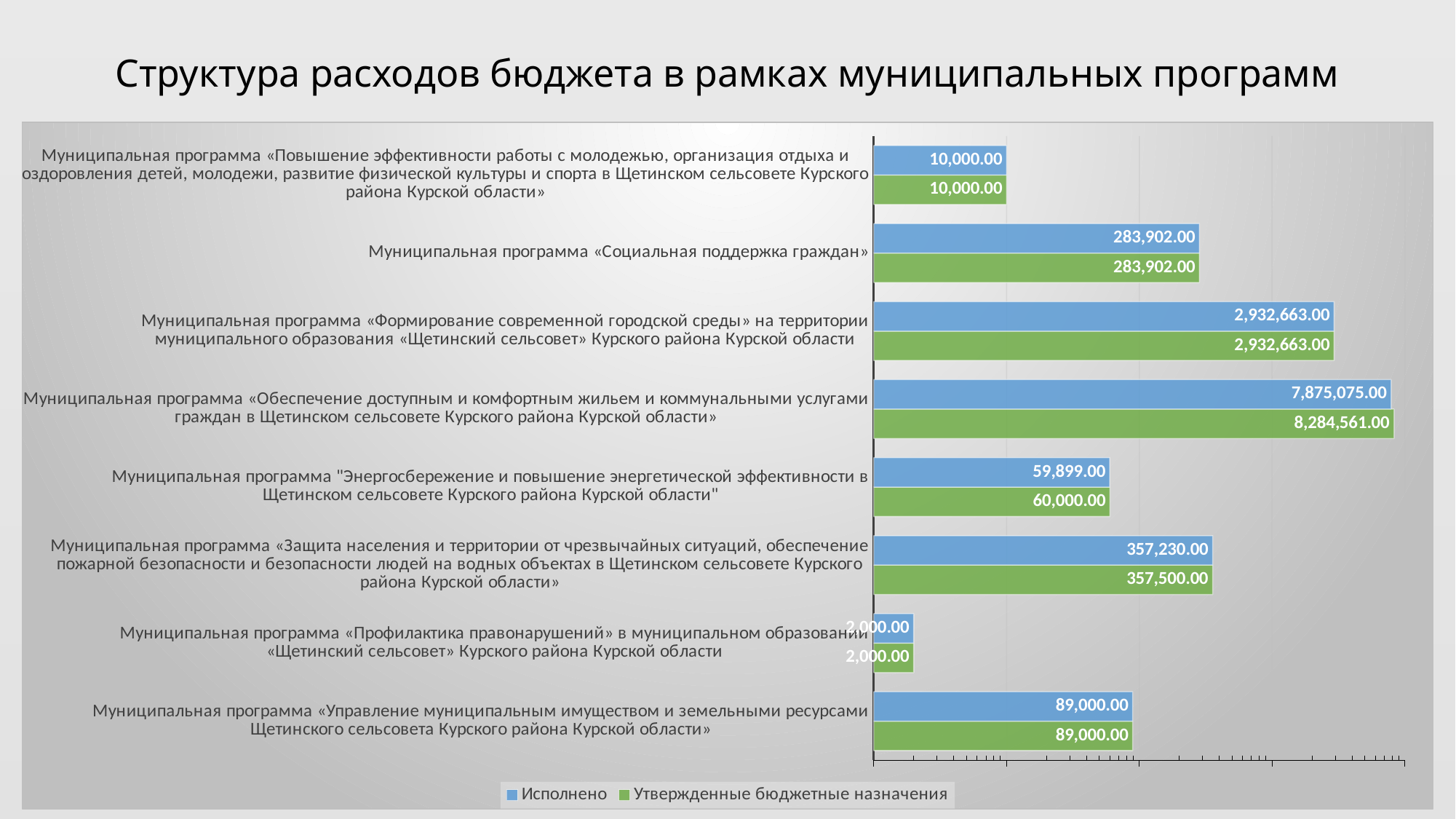
How many municipal programmes (categories) are shown in the chart? 8 Which is larger: the Исполнено value for «Формирование современной городской среды...» or the Исполнено value for «Социальная поддержка граждан»? «Формирование современной городской среды...» Which programme has the lowest Утвержденные бюджетные назначения value? Муниципальная программа «Профилактика правонарушений» в муниципальном образовании «Щетинский сельсовет» Курского района Курской области What is the Утвержденные бюджетные назначения value for the programme «Обеспечение доступным и комфортным жильем и коммунальными услугами граждан в Щетинском сельсовете Курского района Курской области»? 8,284,561.00 For the programme «Обеспечение доступным и комфортным жильем...», what is the difference between Утвержденные бюджетные назначения and Исполнено? 409,486.00 Which series is shown in green in the chart? Утвержденные бюджетные назначения How many series does the legend list? 2 Which programme has the highest Исполнено value? Муниципальная программа «Обеспечение доступным и комфортным жильем и коммунальными услугами граждан в Щетинском сельсовете Курского района Курской области» For the programme «Защита населения и территории от чрезвычайных ситуаций...», what is the difference between Утвержденные бюджетные назначения and Исполнено? 270.00 What is the Исполнено value for the programme «Социальная поддержка граждан»? 283,902.00 What type of chart is shown on the slide? Bar chart What is the Исполнено value for the programme "Энергосбережение и повышение энергетической эффективности в Щетинском сельсовете Курского района Курской области"? 59,899.00